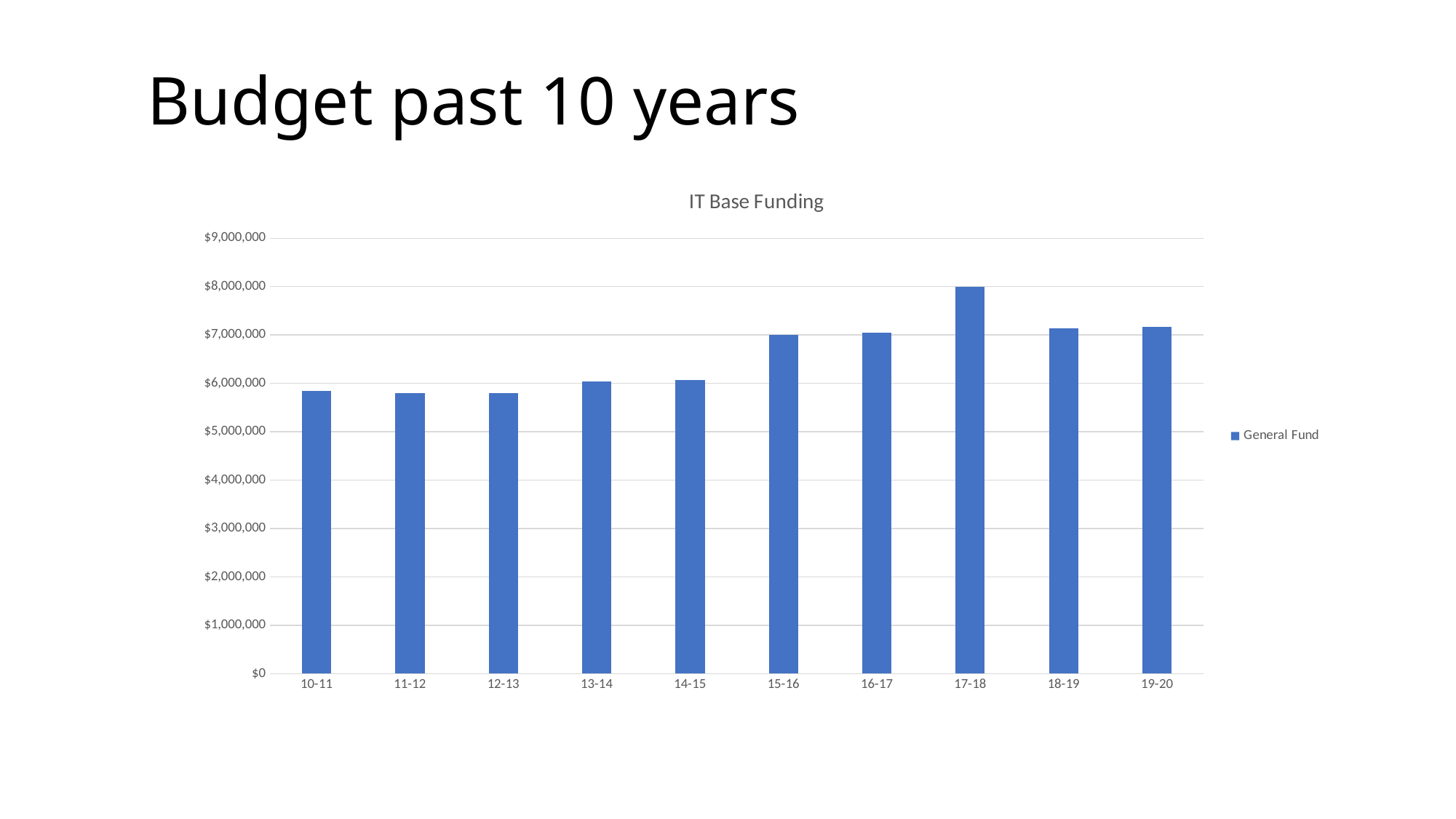
Which is larger, the General Fund value for 15-16 or for 13-14? 15-16 Is the General Fund value for 14-15 greater or less than $7,000,000? less Do the General Fund values generally rise or fall from 10-11 to 17-18? rise Which fiscal year has the highest General Fund value? 17-18 How many fiscal years are shown on the x axis? 10 Is the General Fund value for 17-18 greater or less than $7,000,000? greater Is the General Fund value for 18-19 greater or less than $7,000,000? greater What is the title of the chart? IT Base Funding How many series does the legend list? 1 Which is larger, the General Fund value for 12-13 or for 17-18? 17-18 What kind of chart is shown on the slide? bar chart